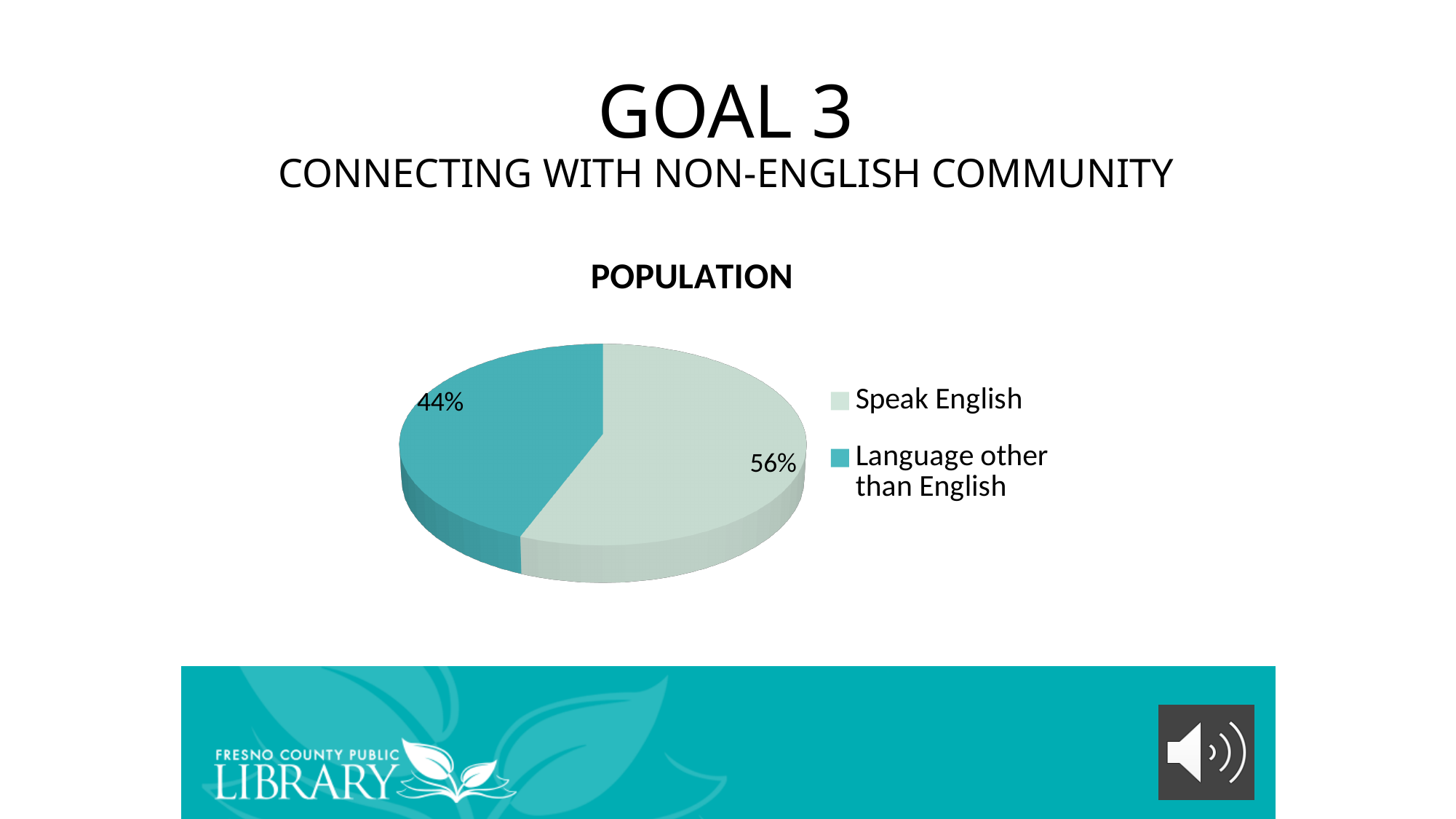
Which is larger: the share for Speak English or the share for Language other than English? Speak English Which legend entry is shown in the darker teal colour? Language other than English Which category has the largest share of the pie? Speak English How many slices does the pie chart have? 2 How many entries does the legend list? 2 What percentage of the population speaks English? 56% What is the difference in percentage points between Speak English and Language other than English? 12 What type of chart is shown on the slide? pie chart Which category has the smallest share of the pie? Language other than English What percentage of the population speaks a language other than English? 44% What is the title of the chart? POPULATION What share of the pie does the Language other than English slice represent? 44%